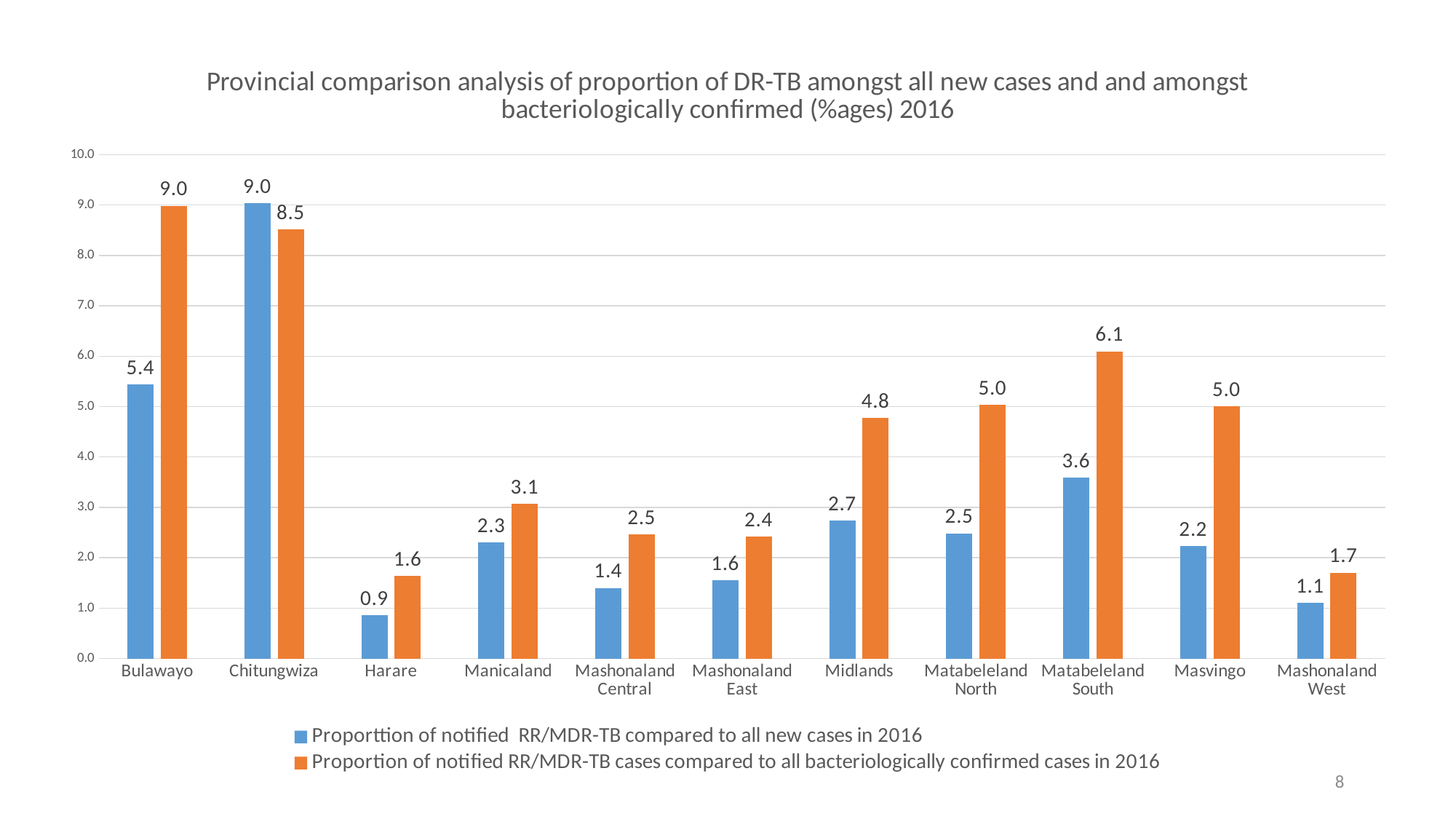
Is the proportion of notified RR/MDR-TB compared to all new cases for Harare greater or less than 1.0? less Which province has the highest proportion of notified RR/MDR-TB compared to all new cases in 2016? Chitungwiza What is the difference between the two series values for Midlands? 2.1 How many provinces are shown on the x axis? 11 What kind of chart is shown on the slide? Bar chart Which is larger for Chitungwiza: the proportion compared to all new cases or the proportion compared to all bacteriologically confirmed cases? Proportion compared to all new cases Which colour represents the proportion of notified RR/MDR-TB cases compared to all bacteriologically confirmed cases in 2016? Orange What is the proportion of notified RR/MDR-TB compared to all new cases in 2016 for Bulawayo? 5.4 Which province has the lowest proportion of notified RR/MDR-TB cases compared to all bacteriologically confirmed cases in 2016? Harare What is the proportion of notified RR/MDR-TB compared to all new cases in 2016 for Mashonaland West? 1.1 How many series does the legend list? 2 What is the proportion of notified RR/MDR-TB cases compared to all bacteriologically confirmed cases in 2016 for Matabeleland South? 6.1